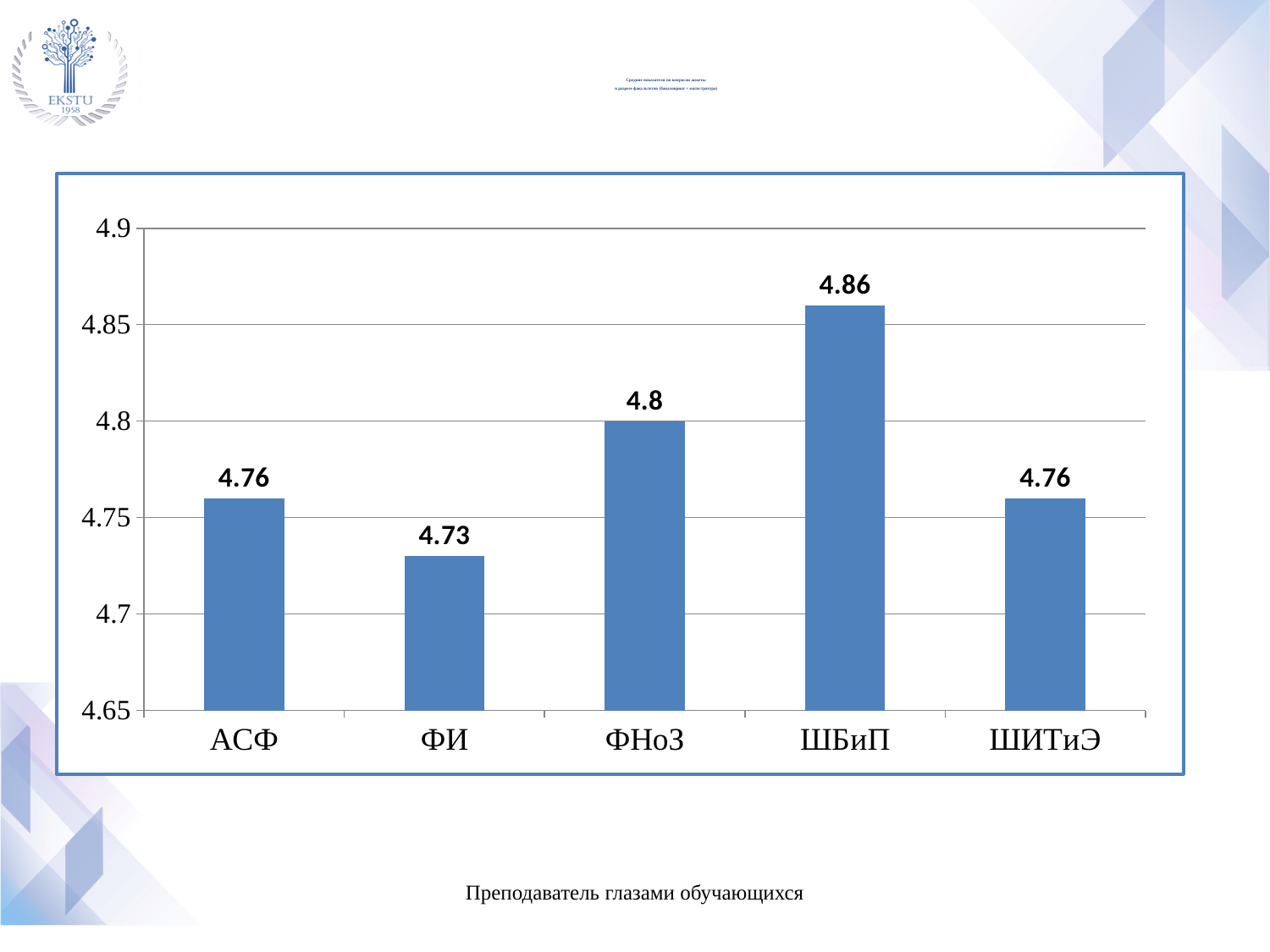
What is the value for ШБиП? 4.86 Which is larger, the value for ФНоЗ or the value for ШИТиЭ? ФНоЗ What is the difference between the values for ШБиП and ФИ? 0.13 What is the difference between the values for ФНоЗ and АСФ? 0.04 What kind of chart is shown on the slide? bar chart Which category has the lowest value? ФИ What is the value for ФИ? 4.73 What is the value for ФНоЗ? 4.8 Is the value for ФИ greater or less than 4.75? less How many categories are shown on the x axis? 5 Which category has the highest value? ШБиП What is the value for АСФ? 4.76